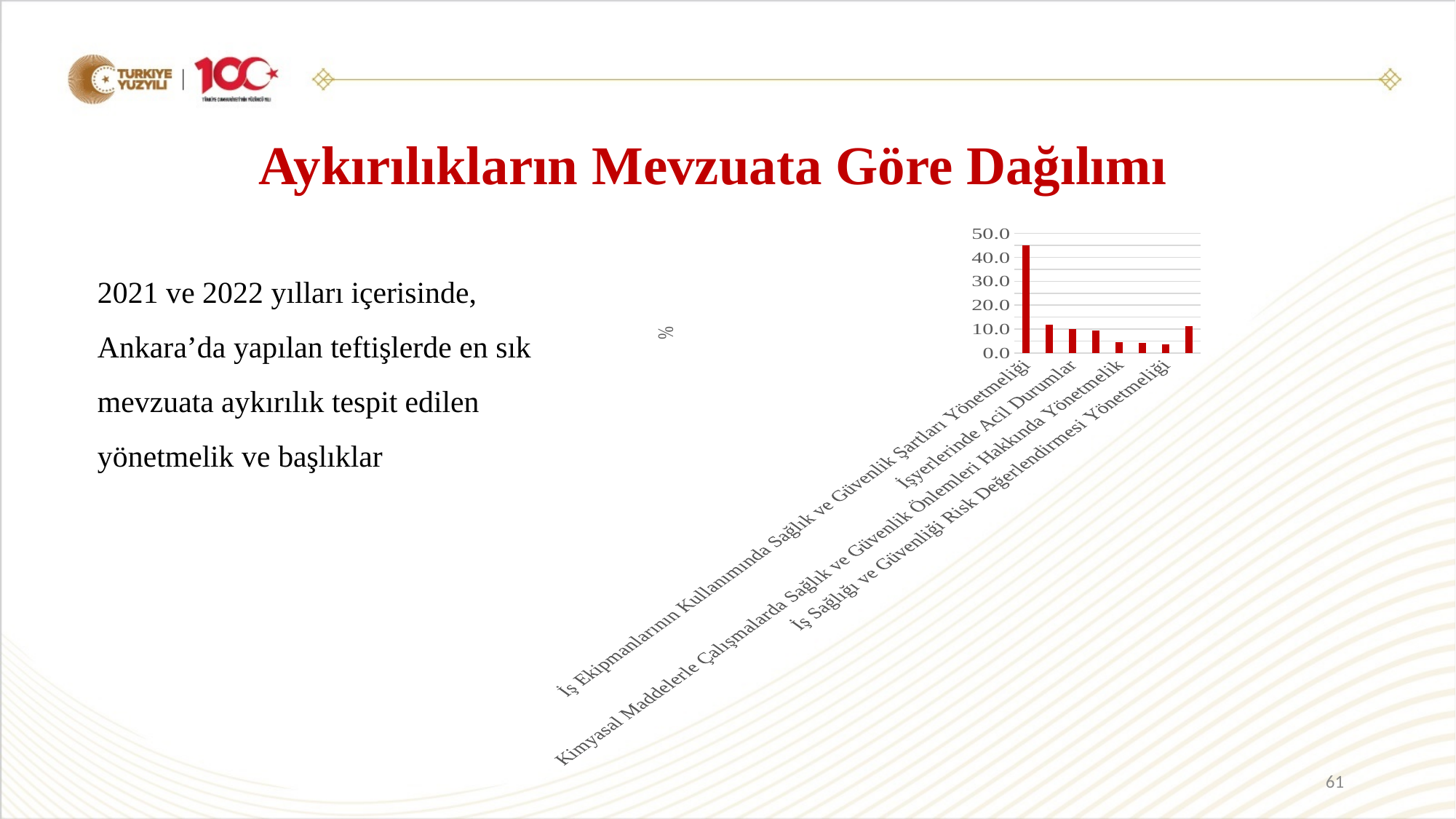
Is the value for İşyerlerinde Acil Durumlar greater or less than 20? less How many bars are plotted in the chart? 8 Which category has the highest value in the chart? İş Ekipmanlarının Kullanımında Sağlık ve Güvenlik Şartları Yönetmeliği Is the value for İş Ekipmanlarının Kullanımında Sağlık ve Güvenlik Şartları Yönetmeliği greater or less than 50? less Is the value for Kimyasal Maddelerle Çalışmalarda Sağlık ve Güvenlik Önlemleri Hakkında Yönetmelik greater or less than 10? less Which is larger: the value for İş Ekipmanlarının Kullanımında Sağlık ve Güvenlik Şartları Yönetmeliği or the value for İşyerlerinde Acil Durumlar? İş Ekipmanlarının Kullanımında Sağlık ve Güvenlik Şartları Yönetmeliği What is the title of the slide containing the chart? Aykırılıkların Mevzuata Göre Dağılımı What kind of chart is shown on the slide? bar chart What is the label on the vertical axis of the chart? % What is the highest tick value shown on the vertical axis? 50.0